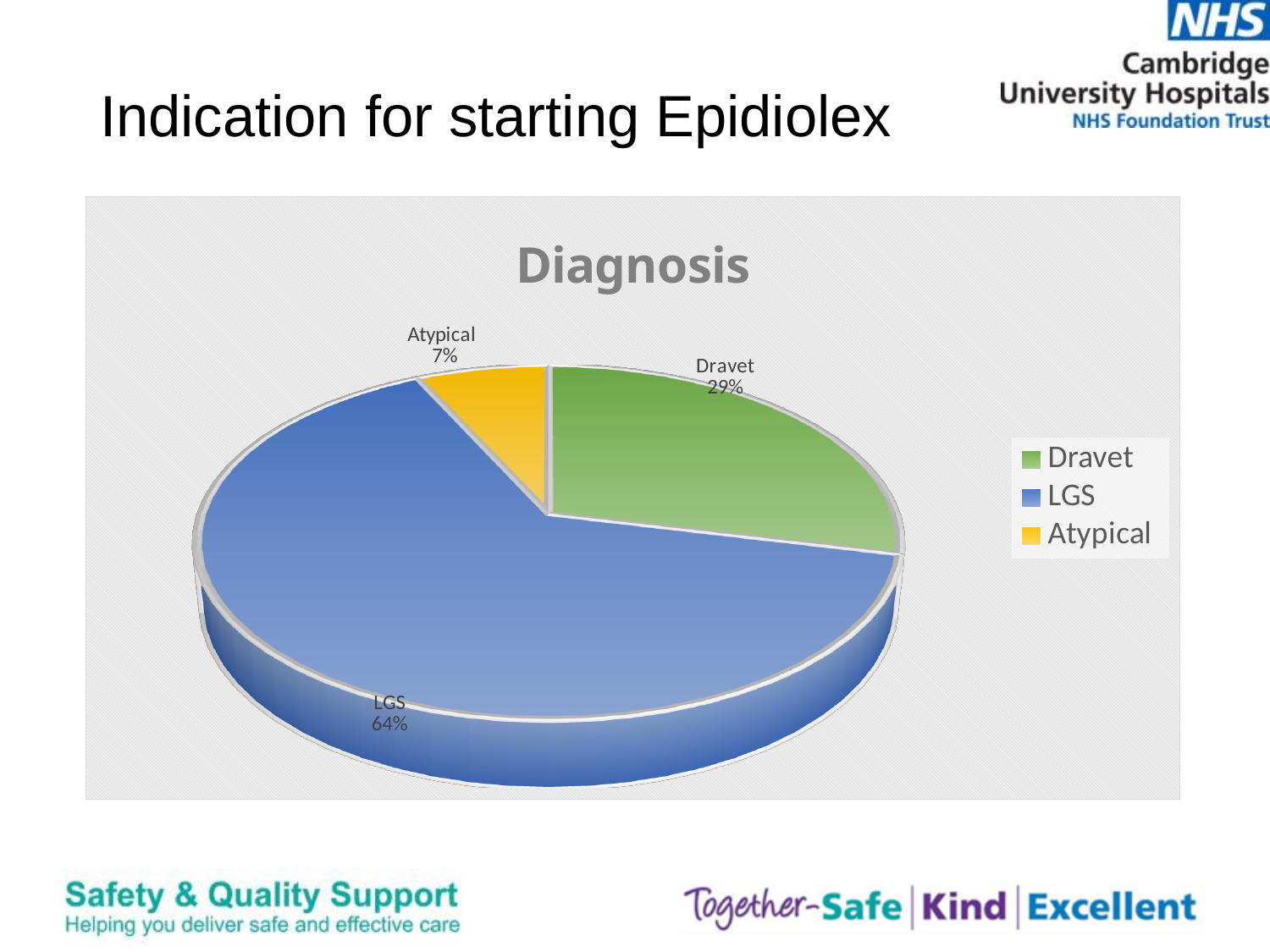
What percentage of the pie is Dravet? 29% What colour is the LGS slice? blue Which is larger, the Dravet slice or the Atypical slice? Dravet What percentage of the pie is Atypical? 7% What is the title of the chart? Diagnosis How many slices does the pie chart have? 3 What type of chart is shown on the slide? pie chart Which diagnosis has the smallest share of the pie? Atypical What is the difference in percentage points between the LGS and Dravet slices? 35 Which diagnosis has the largest share of the pie? LGS How many entries does the legend list? 3 What percentage of the pie is LGS? 64%